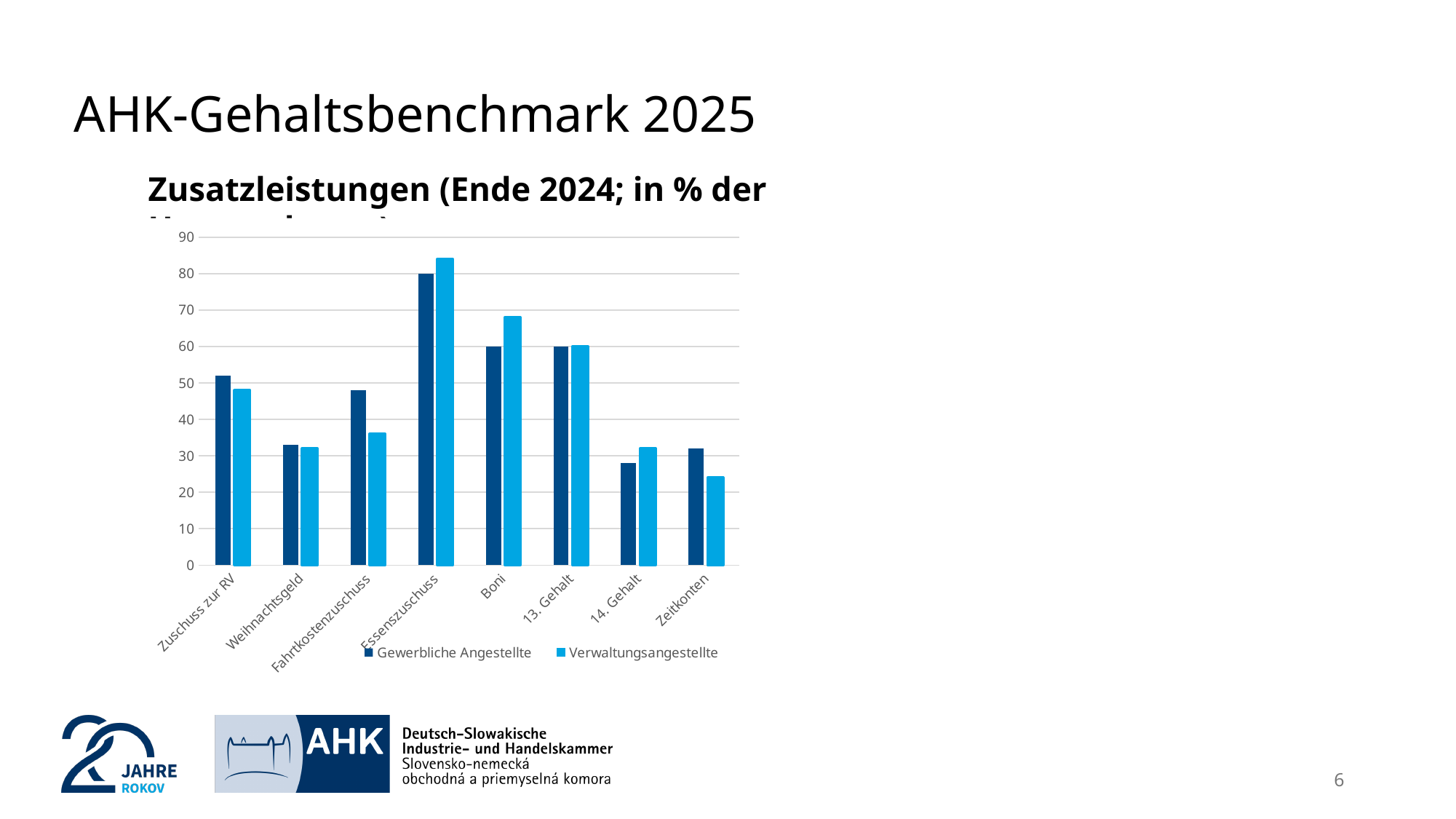
Which category has the lowest value for Verwaltungsangestellte? Zeitkonten What kind of chart is shown on the slide? bar chart Is the value for Gewerbliche Angestellte in Fahrtkostenzuschuss greater or less than 50? less Which series is shown in the lighter blue colour in the chart? Verwaltungsangestellte Which category has the highest value for Verwaltungsangestellte? Essenszuschuss How many categories are shown on the x axis of the chart? 8 For Fahrtkostenzuschuss, which series has the larger value: Gewerbliche Angestellte or Verwaltungsangestellte? Gewerbliche Angestellte Is the value for Verwaltungsangestellte in Zeitkonten greater or less than 30? less Which category has the highest value for Gewerbliche Angestellte? Essenszuschuss For Boni, which series has the larger value: Gewerbliche Angestellte or Verwaltungsangestellte? Verwaltungsangestellte How many series does the chart's legend list? 2 Is the value for Verwaltungsangestellte in Essenszuschuss greater or less than 80? greater